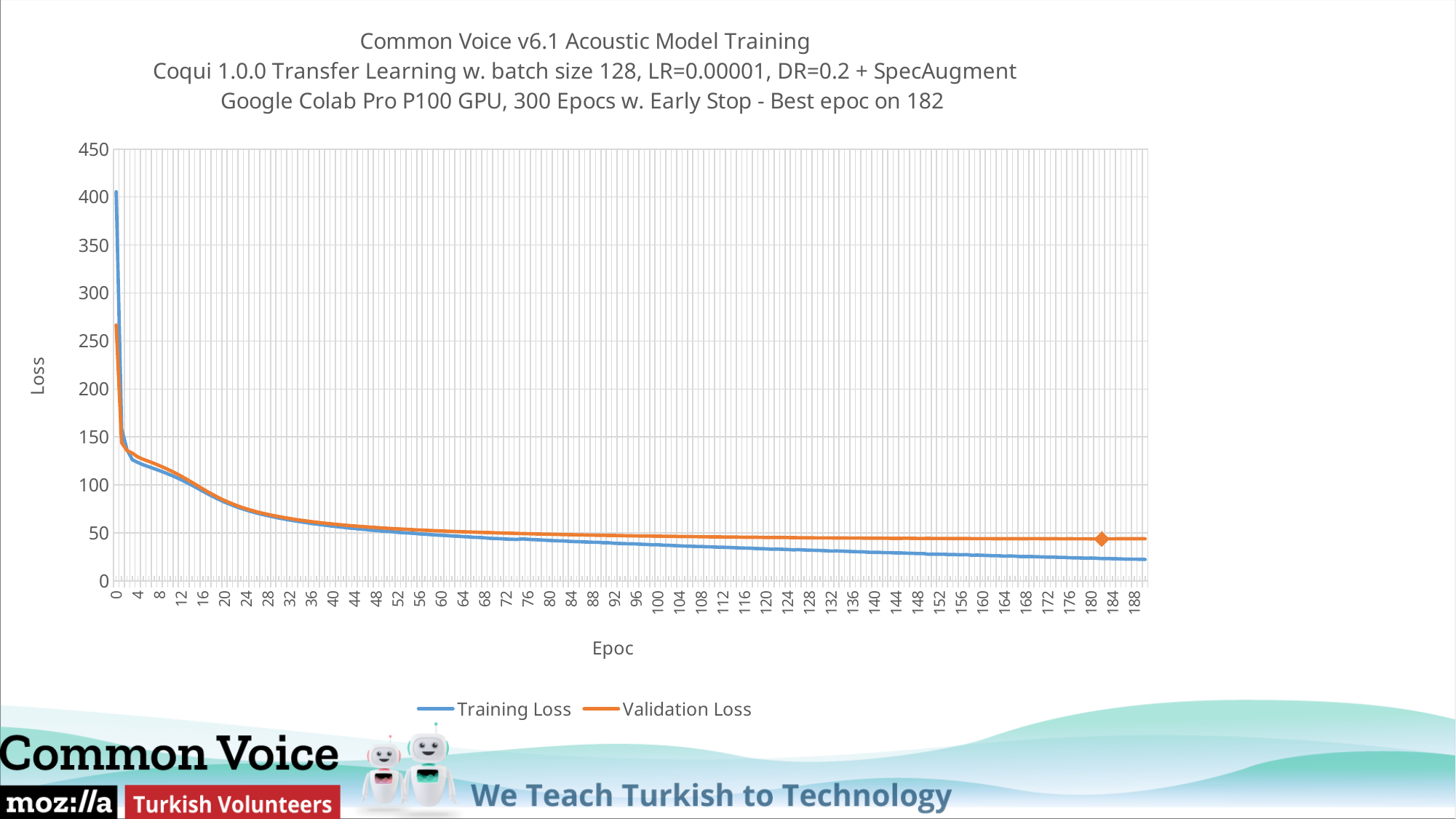
What kind of chart is shown on the slide? Line chart At epoch 188, which series has the higher loss, Training Loss or Validation Loss? Validation Loss Is the Training Loss at epoch 188 greater or less than 50? less What is the label of the y axis? Loss At epoch 0, which series has the higher loss, Training Loss or Validation Loss? Training Loss Is the Validation Loss at epoch 0 greater or less than 250? greater Is the Validation Loss at epoch 0 greater or less than 300? less Do the Validation Loss values rise or fall as the epoch increases? Fall How many series does the legend list? 2 Do the Training Loss values rise or fall as the epoch increases? Fall Which two series are listed in the legend? Training Loss and Validation Loss